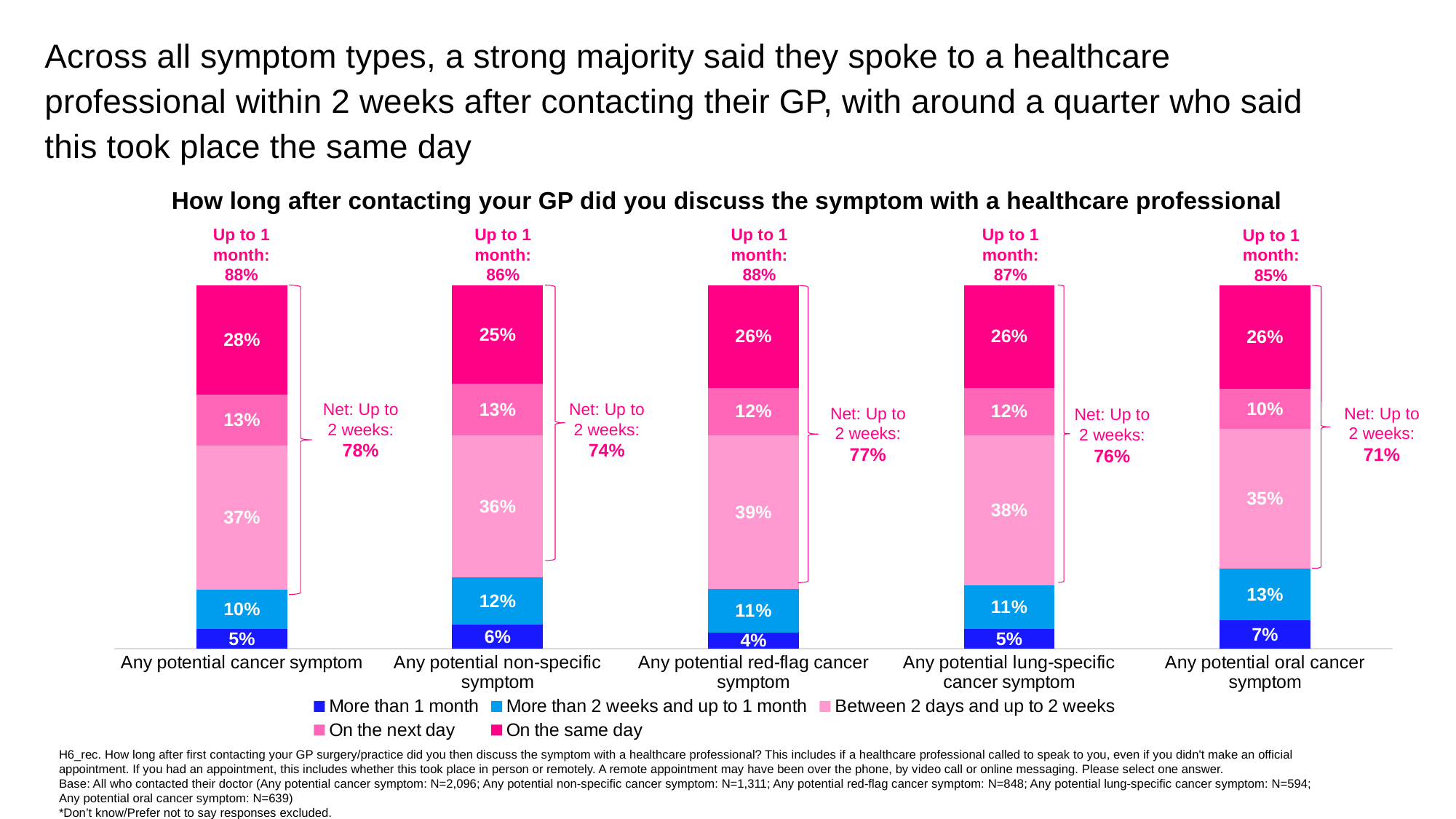
What is the 'Up to 1 month' figure for any potential non-specific symptom? 86% Which symptom type has the lowest percentage for 'More than 1 month'? Any potential red-flag cancer symptom What is the 'Net: Up to 2 weeks' figure for any potential oral cancer symptom? 71% How many series does the legend list? 5 Which symptom type has the highest percentage for 'On the same day'? Any potential cancer symptom Which is larger: the 'More than 2 weeks and up to 1 month' value for any potential oral cancer symptom or for any potential non-specific symptom? Any potential oral cancer symptom Which legend entry is shown in the darkest pink colour at the top of each bar? On the same day What percentage of respondents with any potential cancer symptom said they discussed the symptom on the same day? 28% What percentage of respondents with any potential red-flag cancer symptom said it took between 2 days and up to 2 weeks? 39% What kind of chart is shown on the slide? Stacked bar chart What is the difference between the 'Net: Up to 2 weeks' figures for any potential cancer symptom and any potential oral cancer symptom? 7 percentage points How many symptom types are shown on the x axis? 5